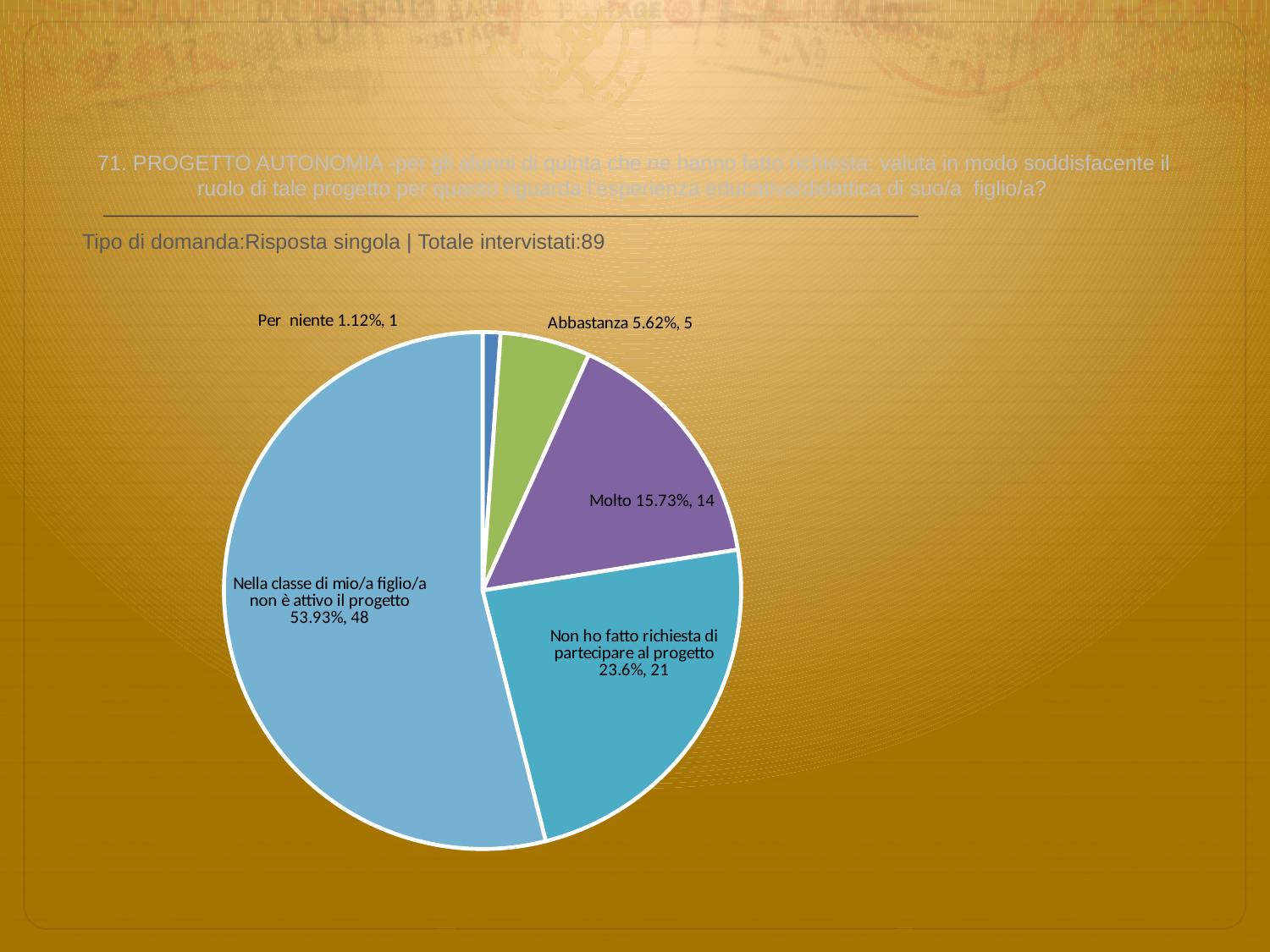
What is the count for "Molto"? 14 What percentage is shown for "Abbastanza"? 5.62% What share of the pie does "Nella classe di mio/a figlio/a non è attivo il progetto" represent? 53.93% What is the difference in count between "Nella classe di mio/a figlio/a non è attivo il progetto" and "Non ho fatto richiesta di partecipare al progetto"? 27 What kind of chart is shown on the slide? pie chart How many slices does the pie chart have? 5 What percentage is shown for "Per niente"? 1.12% Which category has the smallest slice? Per niente What is the total number of respondents stated on the slide? 89 What is the count for "Non ho fatto richiesta di partecipare al progetto"? 21 Which category has the largest slice? Nella classe di mio/a figlio/a non è attivo il progetto Which has a larger count, "Molto" or "Abbastanza"? Molto